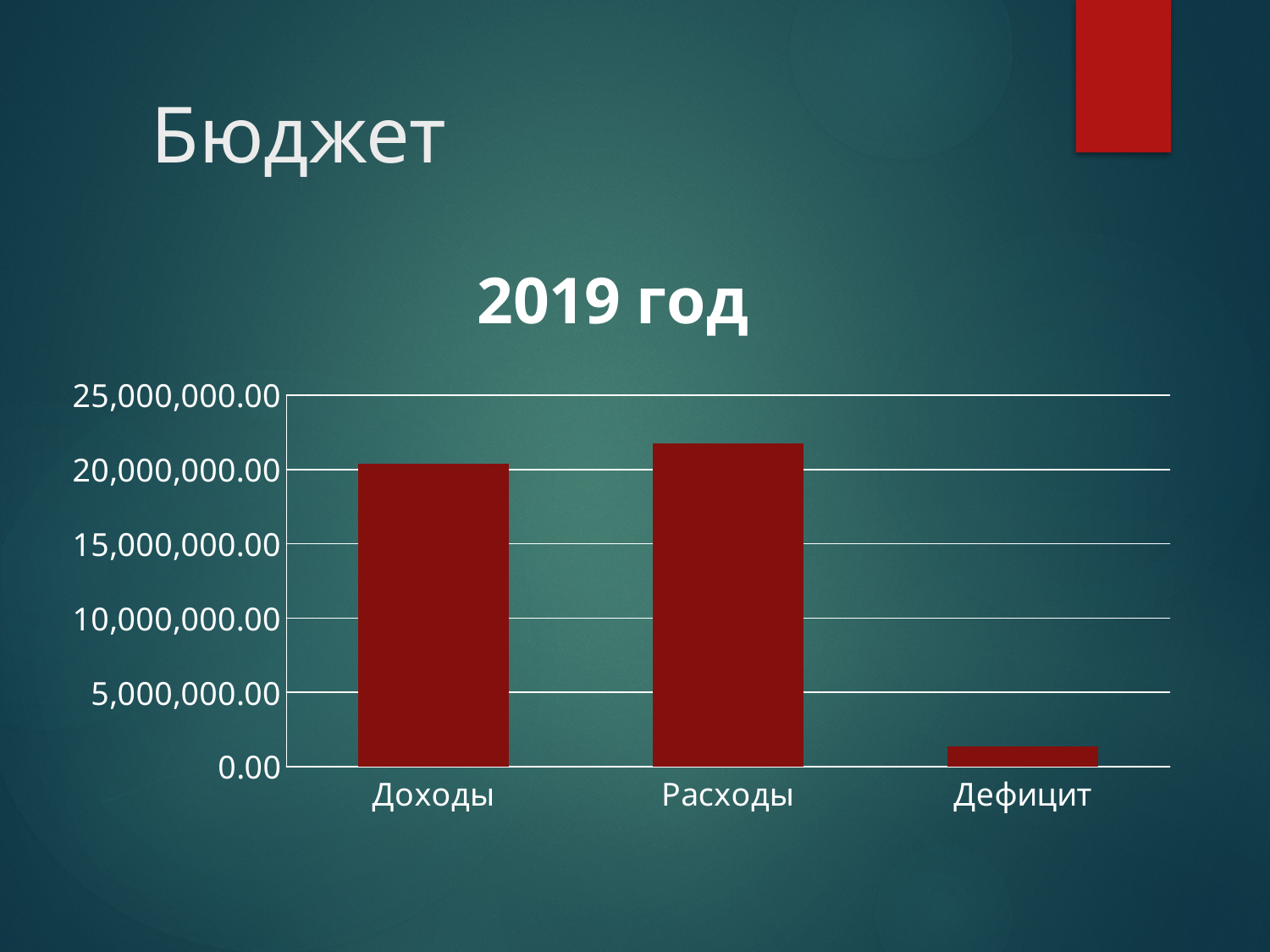
Which is larger, the value for Доходы or the value for Расходы? Расходы Is the value for Доходы greater or less than 20,000,000.00? greater Is the value for Расходы greater or less than 25,000,000.00? less Is the value for Расходы greater or less than 20,000,000.00? greater Which category has the lowest value in the chart? Дефицит Which is larger, the value for Доходы or the value for Дефицит? Доходы How many categories are shown on the x axis of the chart? 3 What colour are the bars in the chart? dark red What is the title of the chart? 2019 год Which category has the highest value in the chart? Расходы What kind of chart is shown on the slide? bar chart